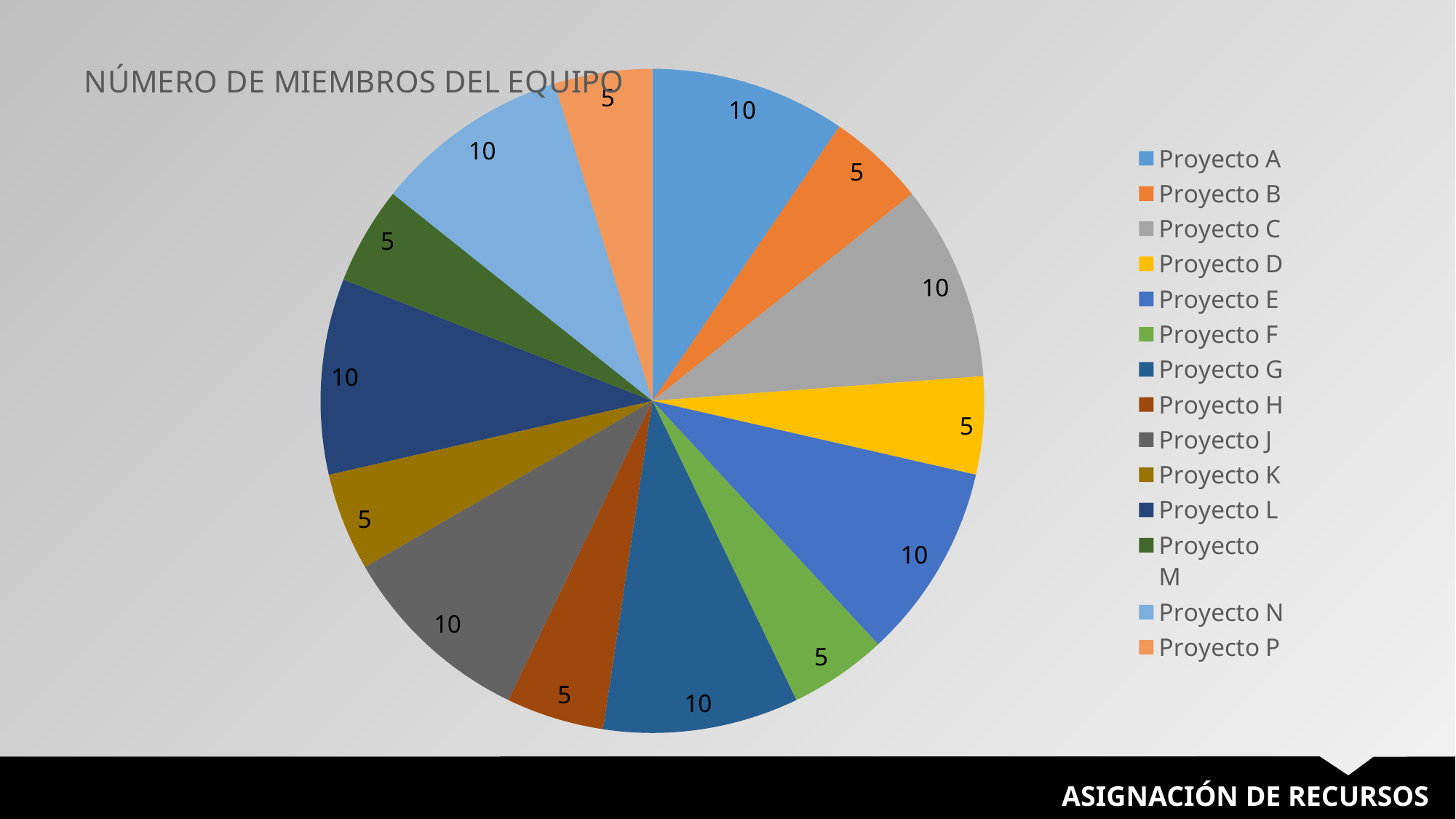
What type of chart is shown on the slide? pie chart Which is larger, the value for Proyecto C or the value for Proyecto H? Proyecto C What is the value for Proyecto G? 10 What is the value for Proyecto B? 5 What colour is the slice for Proyecto D? yellow What is the title of the chart? NÚMERO DE MIEMBROS DEL EQUIPO What is the value for Proyecto D? 5 How many projects have a value of 10? 7 How many projects (slices) does the pie chart show? 14 What is the value for Proyecto A? 10 What is the value for Proyecto P? 5 What is the difference between the value for Proyecto L and the value for Proyecto K? 5